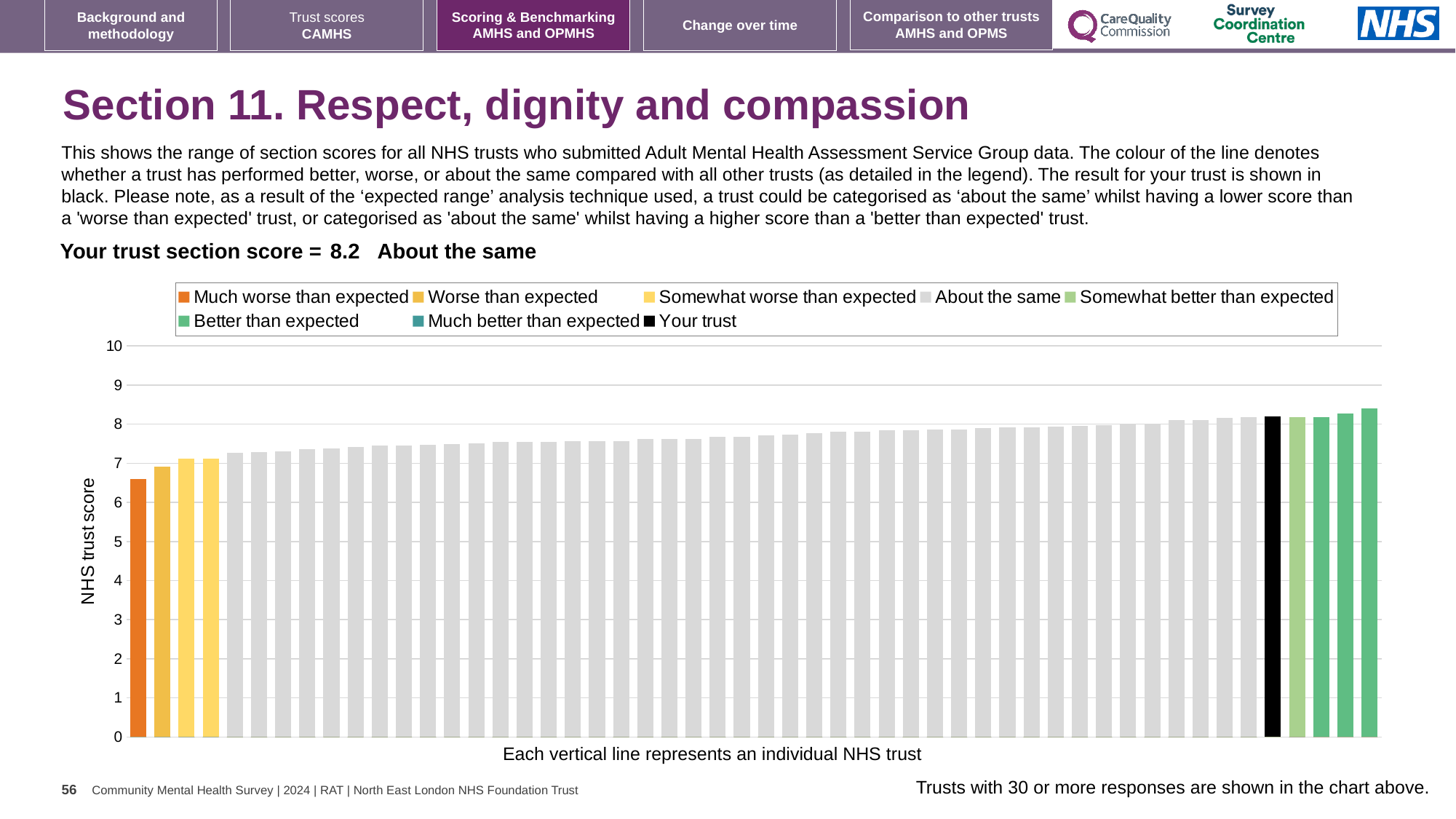
How is your trust's score categorised compared with other trusts? About the same What kind of chart is shown on the slide? Bar chart Is the value of the lowest bar (the orange bar) greater or less than 7? less What colour is the bar representing your trust? Black Is the value for your trust (the black bar) greater or less than 8? greater What is the section score for your trust shown on the slide? 8.2 Which is higher, the black bar for your trust or the orange bar? The black bar How many entries does the chart legend list? 8 How many bars are coloured orange (Much worse than expected)? 1 Do the bar values rise or fall from left to right along the x axis? Rise What is the label on the vertical axis of the chart? NHS trust score Is the value of the highest bar greater or less than 9? less